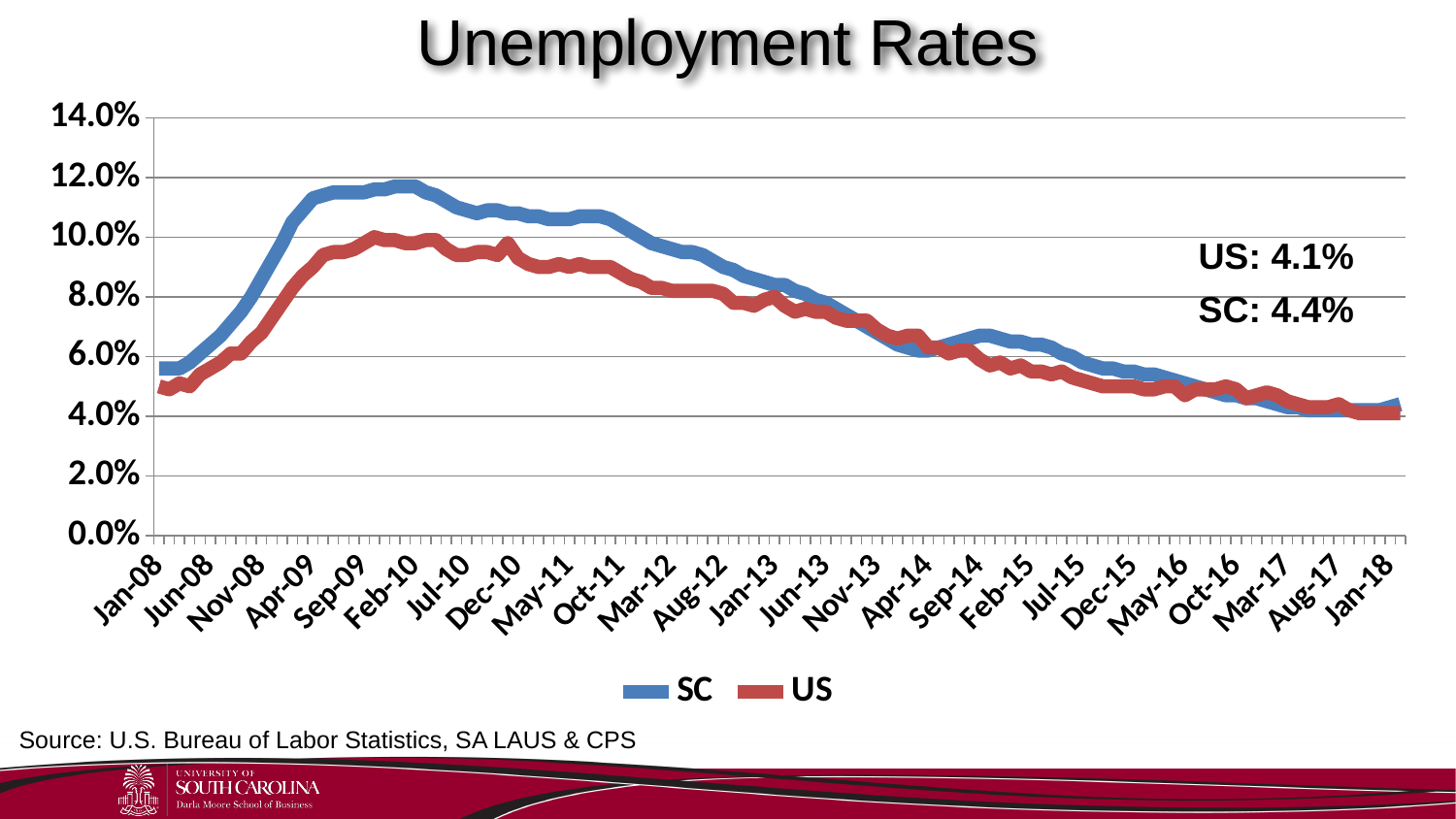
What US unemployment rate is annotated on the chart? 4.1% What is the difference between the annotated SC rate and the annotated US rate? 0.3% Which series reaches the higher peak, SC or US? SC Is the US value at Jan-08 greater or less than 6.0%? less Does the SC line rise or fall from Feb-10 to Jan-18? fall Is the SC value at Feb-10 greater or less than 10.0%? greater What is the title of the chart? Unemployment Rates Which annotated rate is larger, SC or US? SC What kind of chart is shown on the slide? line chart How many series does the legend list? 2 What are the two series named in the legend? SC and US What SC unemployment rate is annotated on the chart? 4.4%